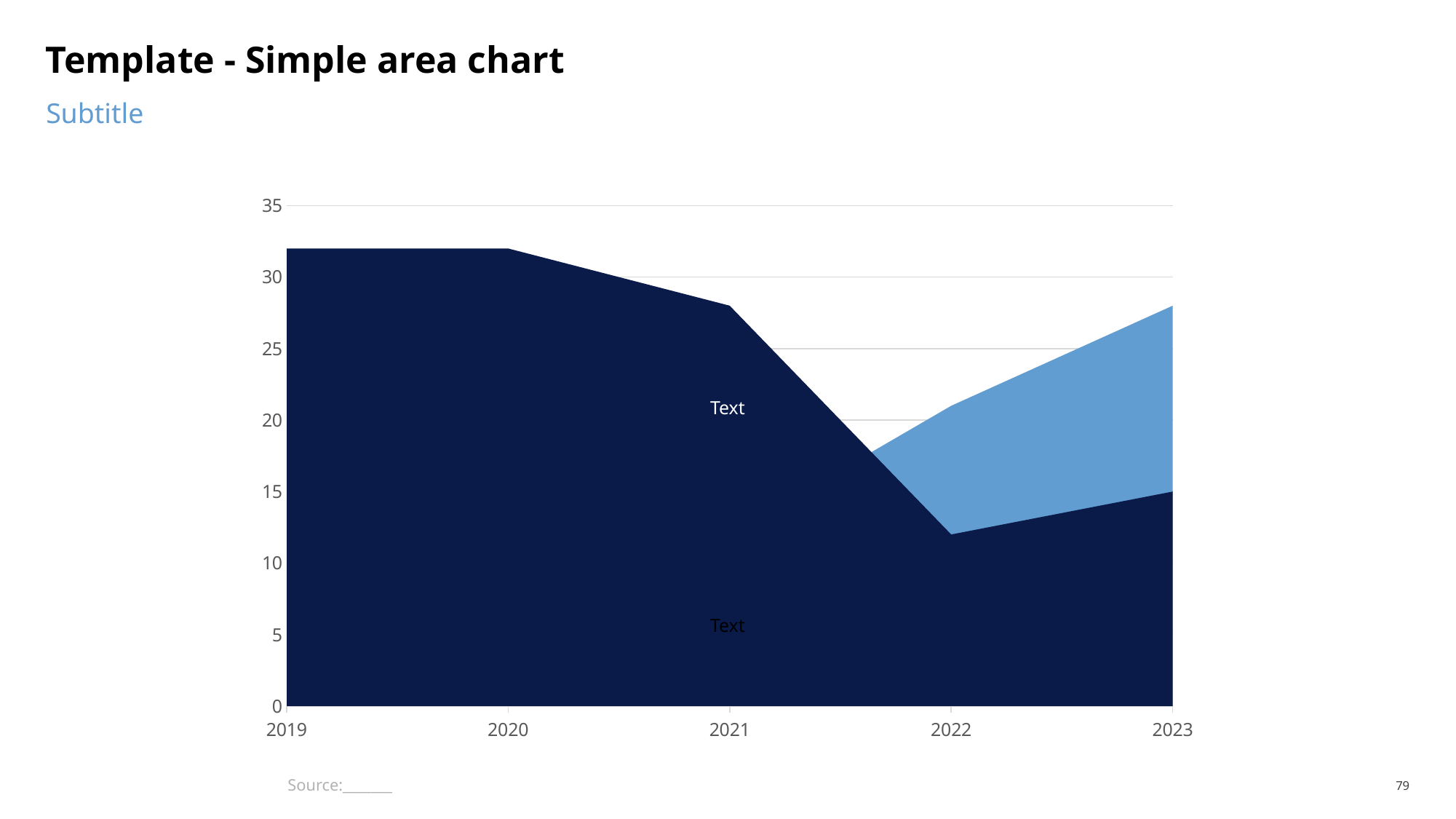
How many years are shown on the x axis of the chart? 5 Is the value of the dark blue area in 2019 greater or less than 30? greater What is the title of the slide? Template - Simple area chart Is the value of the dark blue area in 2023 greater or less than 20? less Which year has the larger value for the dark blue area, 2020 or 2022? 2020 Is the value of the dark blue area in 2021 greater or less than 25? greater Does the dark blue area rise or fall from 2019 to 2022? Falls What is the highest value shown on the y axis of the chart? 35 What kind of chart is shown on the slide? Area chart In which year is the dark blue area at its lowest? 2022 Which year has the larger value for the dark blue area, 2021 or 2023? 2021